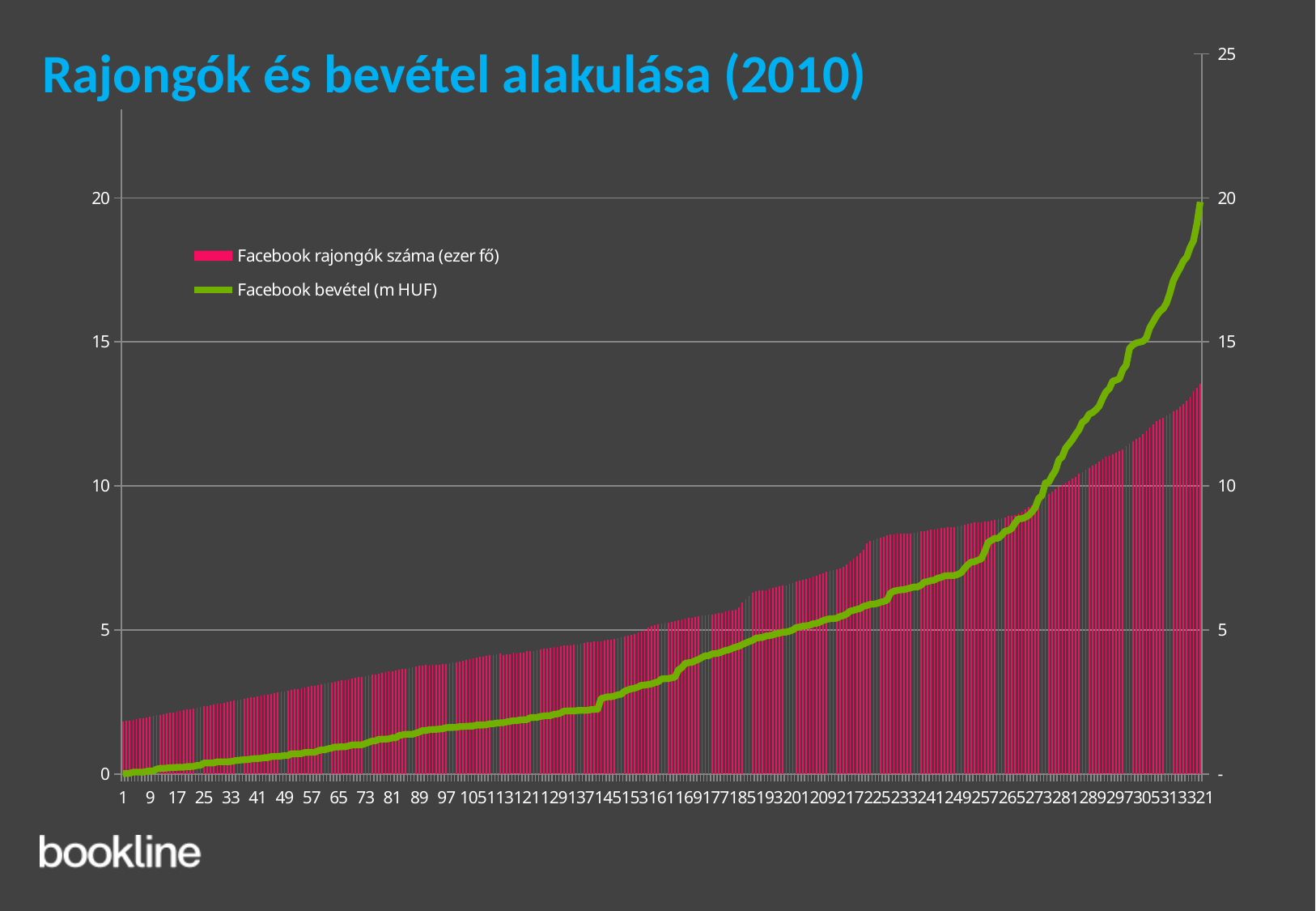
What kind of chart is this? Combined bar and line chart Does the Facebook bevétel (m HUF) line rise or fall along the x axis? Rise Is the value of Facebook bevétel (m HUF) at x = 1 greater or less than 5 on the right axis? less Is the value of Facebook rajongók száma (ezer fő) at x = 241 greater or less than 10? less Is the value of Facebook bevétel (m HUF) at x = 321 greater or less than 15 on the right axis? greater How many series does the legend list? 2 Which series is drawn as a green line? Facebook bevétel (m HUF) What is the title of the chart? Rajongók és bevétel alakulása (2010) Do the Facebook rajongók száma (ezer fő) bars rise or fall along the x axis? Rise